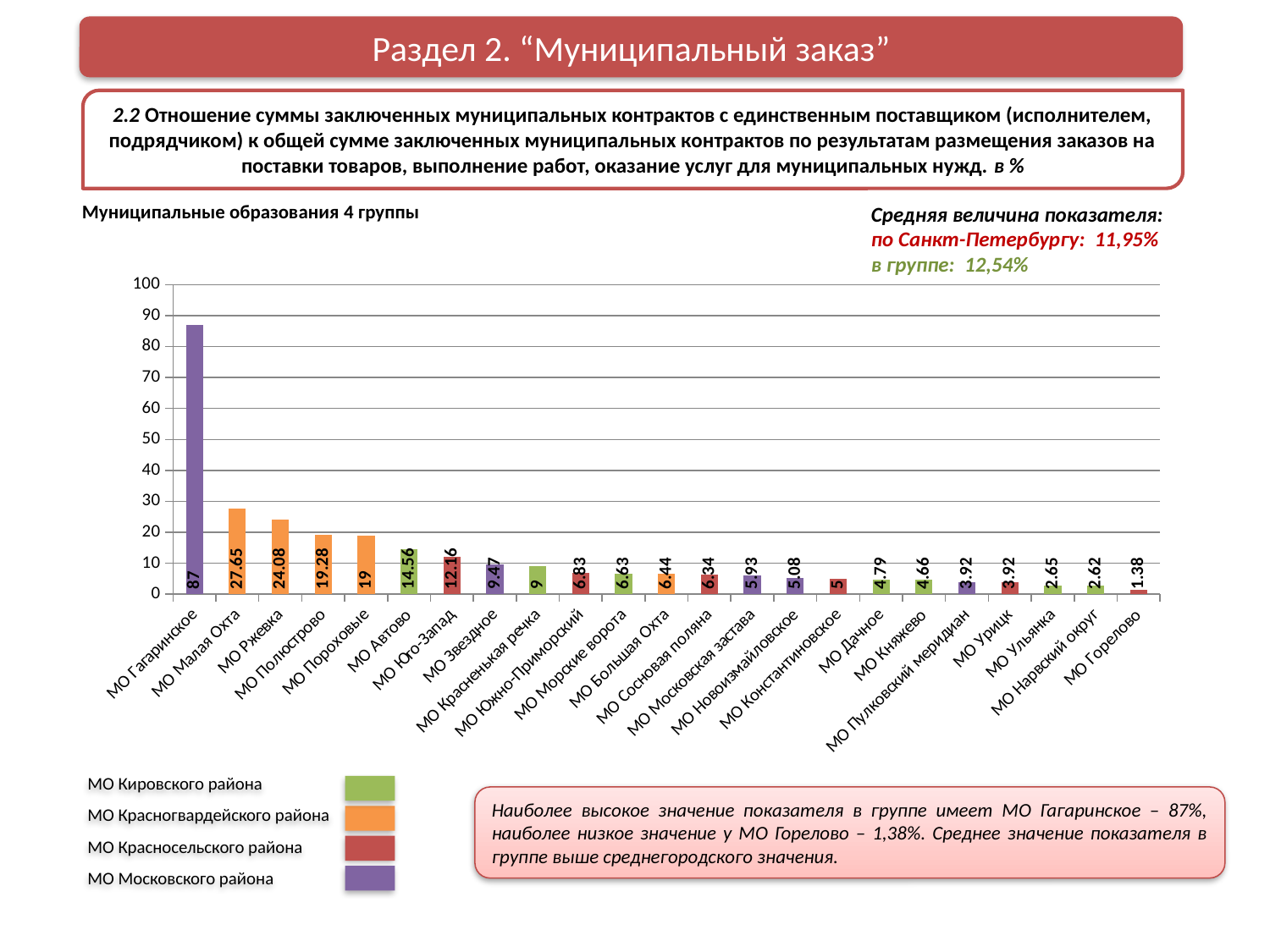
What is the value for МО Гагаринское? 87 What is the value for МО Автово? 14.56 Which municipality has the highest value on the chart? МО Гагаринское How many municipalities are shown on the chart? 23 What is the difference between the values for МО Ржевка and МО Полюстрово? 4.8 What is the value for МО Горелово? 1.38 Which colour represents МО Московского района in the legend? purple What is the value for МО Малая Охта? 27.65 Which municipality has the lowest value on the chart? МО Горелово Which is larger, the value for МО Юго-Запад or the value for МО Звездное? МО Юго-Запад What kind of chart is shown on the slide? bar chart How many district groups does the legend list? 4